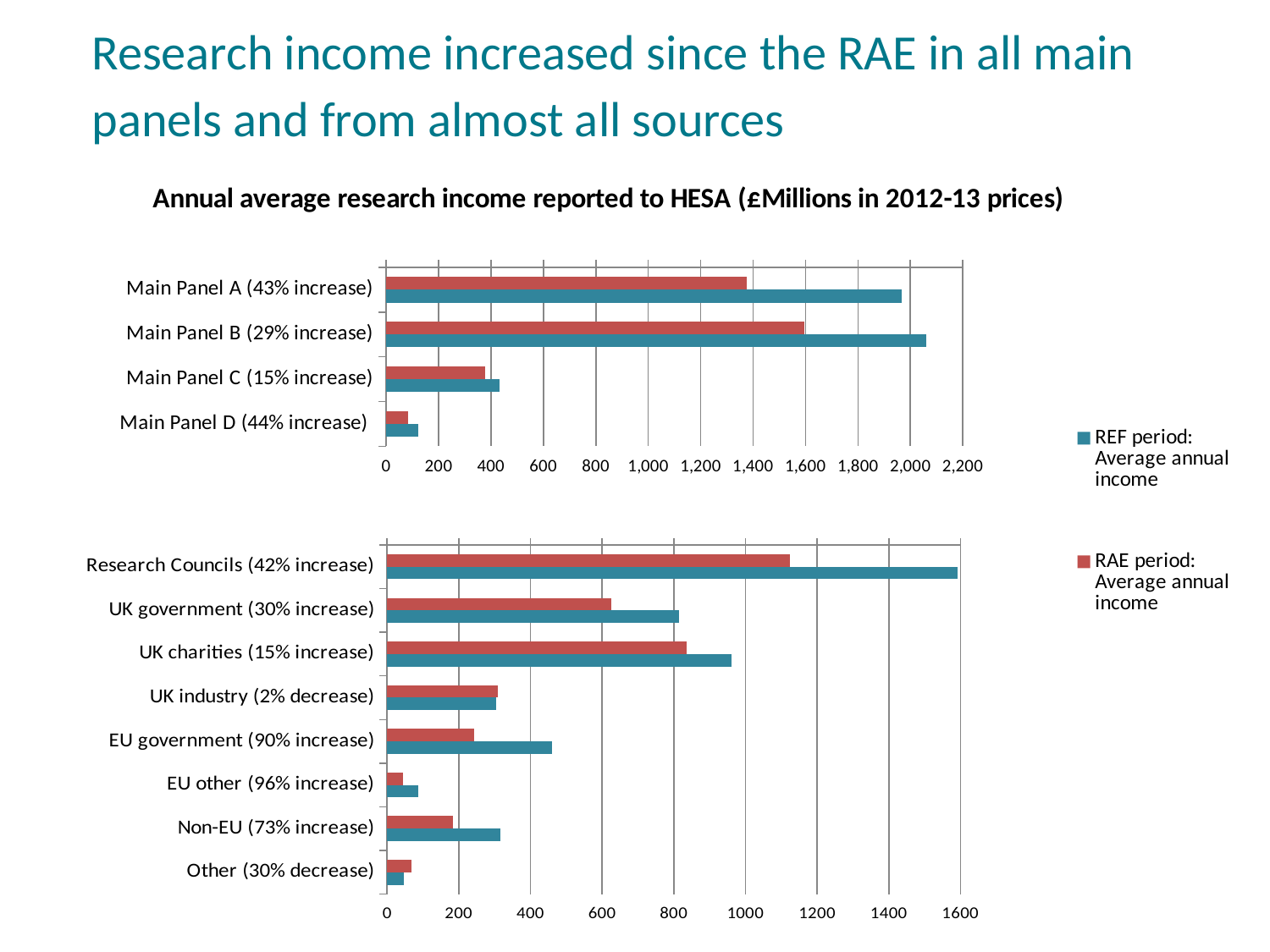
In the top chart, which main panel has the lowest REF period average annual income? Main Panel D (44% increase) How many categories does the bottom chart (income sources) show? 8 In the top chart, which main panel has the highest REF period average annual income? Main Panel B (29% increase) How many series does the legend list? 2 In the bottom chart, is the REF period value for EU government greater or less than 400? greater In the bottom chart, which source has the highest REF period average annual income? Research Councils (42% increase) In the bottom chart, which is larger for the REF period: UK charities or UK government? UK charities What is the title shown above the charts? Annual average research income reported to HESA (£Millions in 2012-13 prices) How many categories does the top chart (Main Panels) show? 4 In the top chart, is the REF period value for Main Panel A greater or less than 1,800? greater In the bottom chart, is the RAE period value for Research Councils greater or less than 1000? greater What kind of chart is the top chart on the slide? bar chart